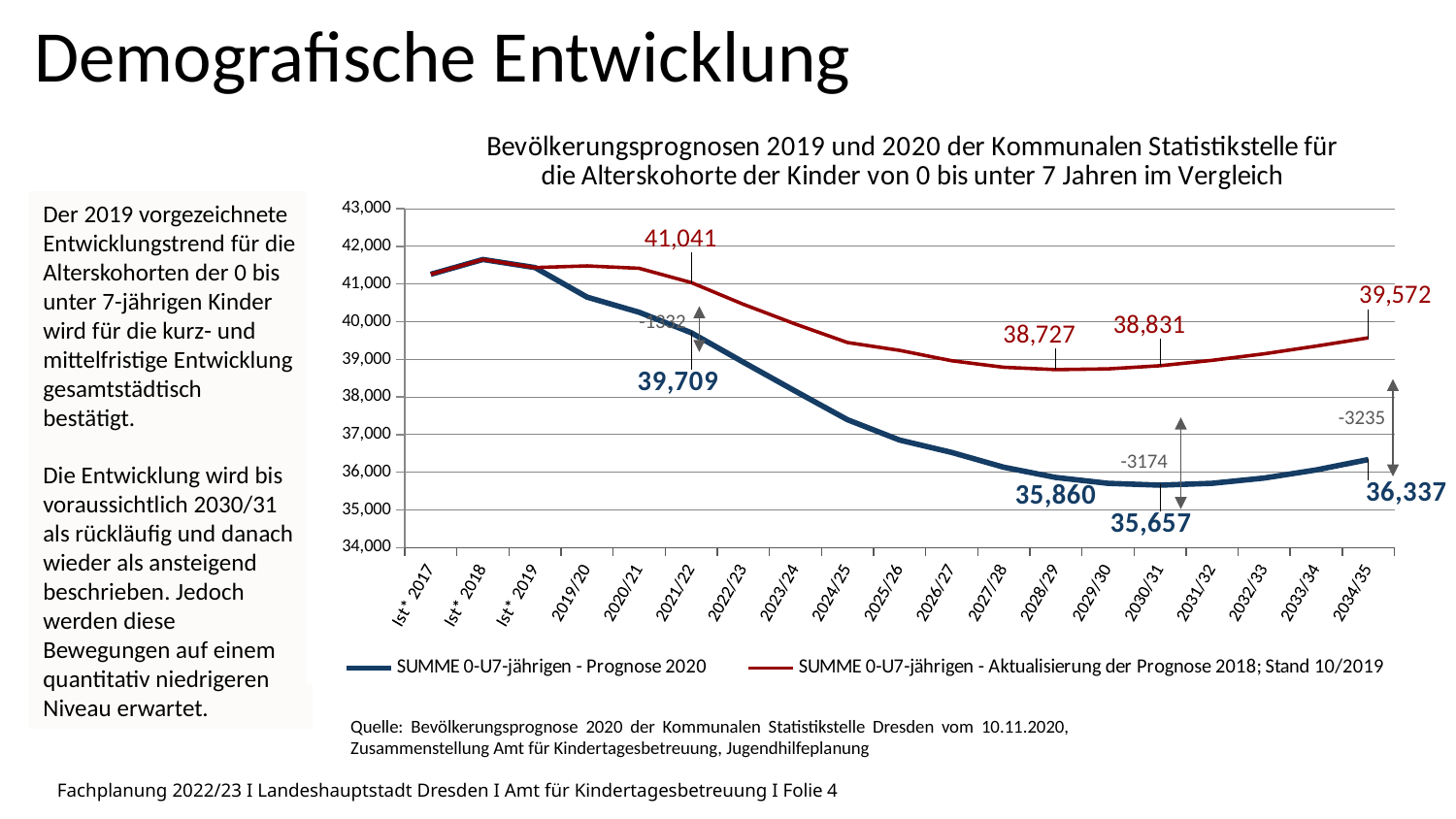
Which series has the higher value in 2030/31: 'Prognose 2020' or 'Aktualisierung der Prognose 2018'? Aktualisierung der Prognose 2018 What type of chart is shown on the slide? line chart How many series does the legend list? 2 How many categories are shown on the x axis? 19 What is the value of the 'Aktualisierung der Prognose 2018' series in 2034/35? 39,572 What is the difference between the two series in 2034/35 (39,572 and 36,337)? 3,235 What is the value of the 'Aktualisierung der Prognose 2018; Stand 10/2019' series in 2021/22? 41,041 What is the value of the 'Prognose 2020' series in 2034/35? 36,337 What is the value of the 'Prognose 2020' series in 2021/22? 39,709 What is the value of the 'Prognose 2020' series in 2030/31? 35,657 What is the difference between the two series in 2028/29 (38,727 and 35,860)? 2,867